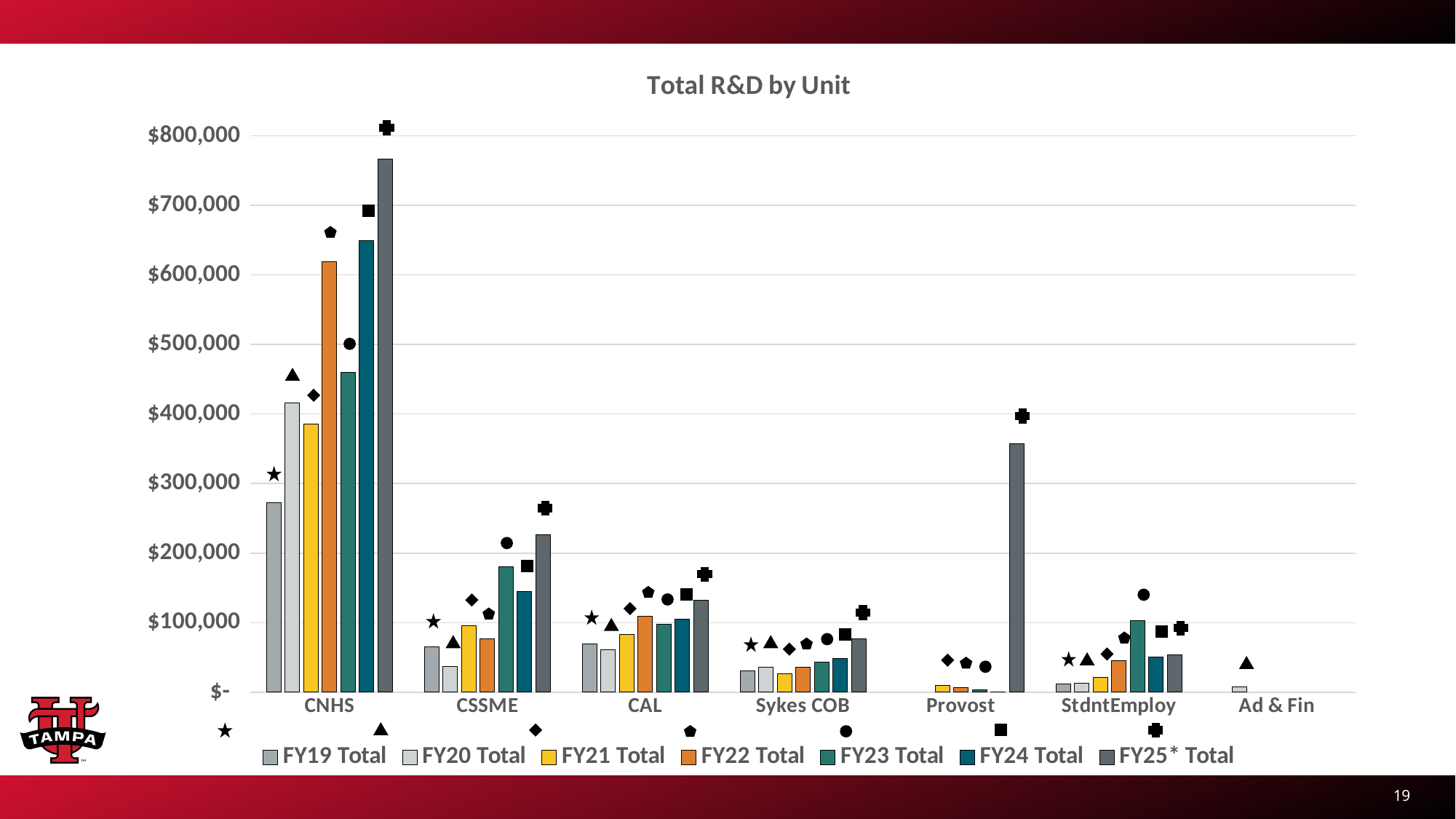
How many series does the legend list? 7 Which unit has the lowest bars overall? Ad & Fin Is the FY25* Total value for Provost greater or less than $300,000? greater What kind of chart is shown on the slide? bar chart Is the FY25* Total value for CNHS greater or less than $700,000? greater What is the title of the chart? Total R&D by Unit Is the FY25* Total value for Sykes COB greater or less than $100,000? less For CNHS, which is larger: the FY22 Total or the FY23 Total? FY22 Total How many units (categories) are shown on the x axis? 7 Which unit has the highest FY25* Total bar? CNHS For Sykes COB, do the values rise or fall from FY21 Total to FY25* Total? rise